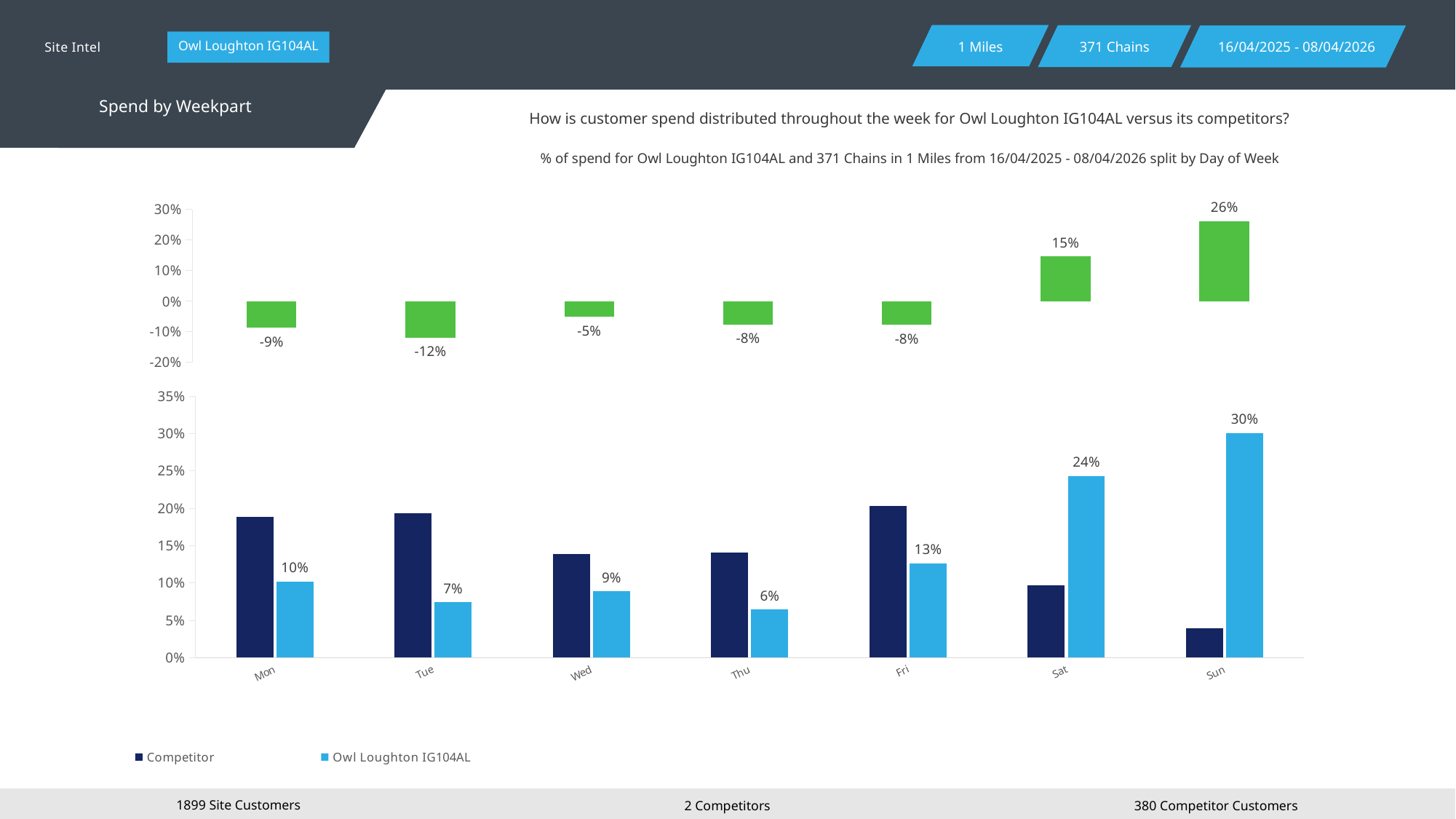
In the bottom chart, is the Competitor value on Sun greater or less than 5%? less In the top chart, what is the value of the rightmost bar? 26% In the bottom chart, which day has the lowest value for Owl Loughton IG104AL? Thu In the bottom chart, what is the value for Owl Loughton IG104AL on Thu? 6% How many days are shown on the x axis of the bottom chart? 7 In the bottom chart, which is larger on Fri: the Competitor value or the Owl Loughton IG104AL value? Competitor How many series does the legend of the bottom chart list? 2 In the top chart, what is the value of the second bar from the left? -12% In the bottom chart, is the Competitor value on Mon greater or less than 15%? greater In the bottom chart, what is the value for Owl Loughton IG104AL on Sun? 30% In the bottom chart, which day has the highest value for Owl Loughton IG104AL? Sun In the bottom chart, what is the difference between the Owl Loughton IG104AL values for Sat and Fri? 11%